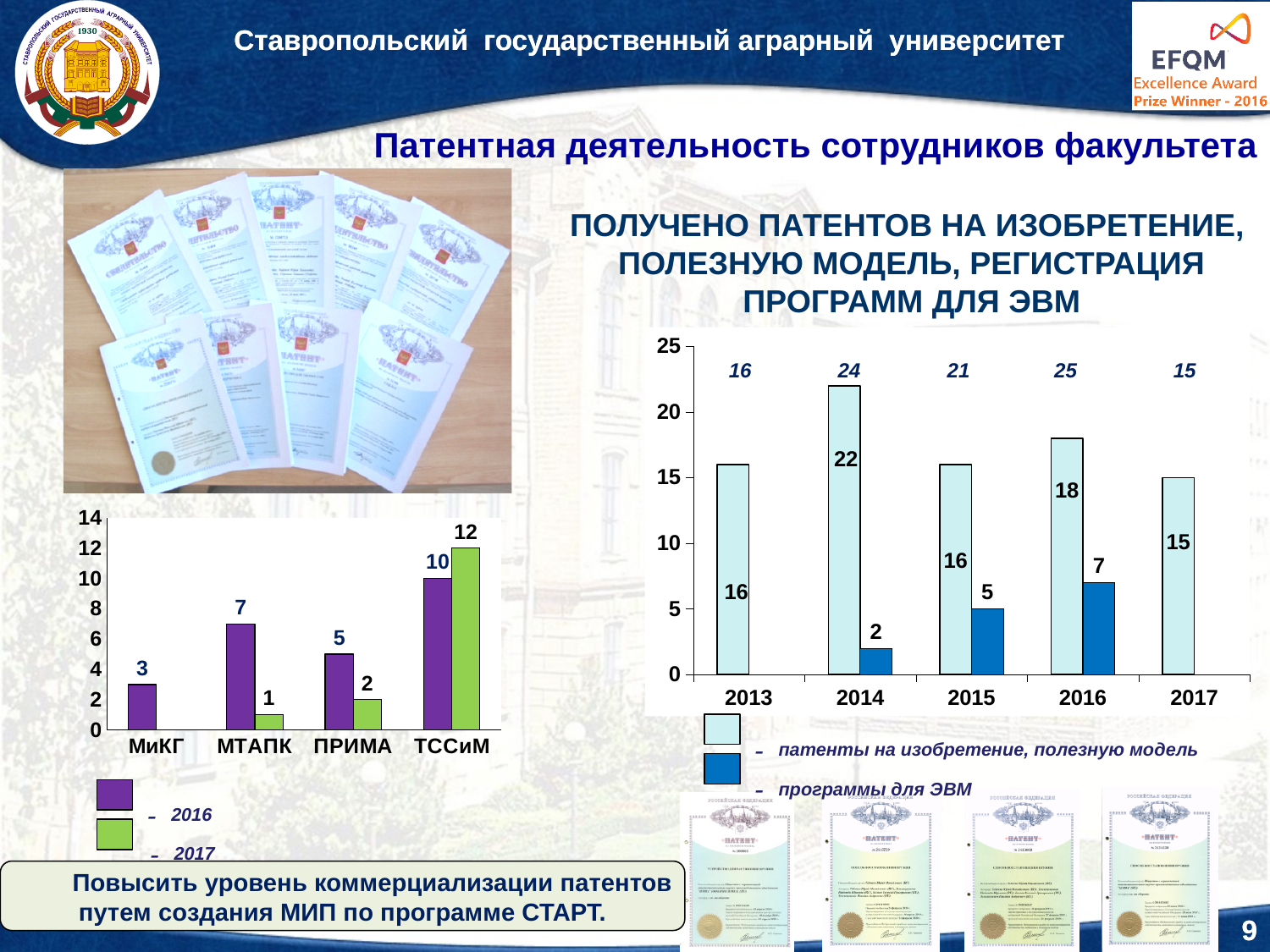
In the right-hand chart (patents by year), how many years are shown on the x axis? 5 In the right-hand chart (patents by year), how many computer programs (программы для ЭВМ) were registered in 2016? 7 In the right-hand chart (patents by year), what is the difference between the number of patents for inventions and utility models in 2014 and in 2015? 6 In the right-hand chart (patents by year), which year has the lowest number of patents for inventions and utility models? 2017 In the right-hand chart (patents by year), how many patents for inventions and utility models were obtained in 2014? 22 In the bottom-left chart (by department), what is the 2017 value for ТССиМ? 12 In the bottom-left chart (by department), which is larger for МТАПК: the 2016 value or the 2017 value? 2016 What type of chart is the bottom-left chart (by department)? Bar chart In the right-hand chart (patents by year), what total is printed above the bars for 2016? 25 In the right-hand chart (patents by year), how many series does the legend list? 2 In the right-hand chart (patents by year), which year has the highest number of patents for inventions and utility models? 2014 In the bottom-left chart (by department), which department has the highest 2016 value? ТССиМ